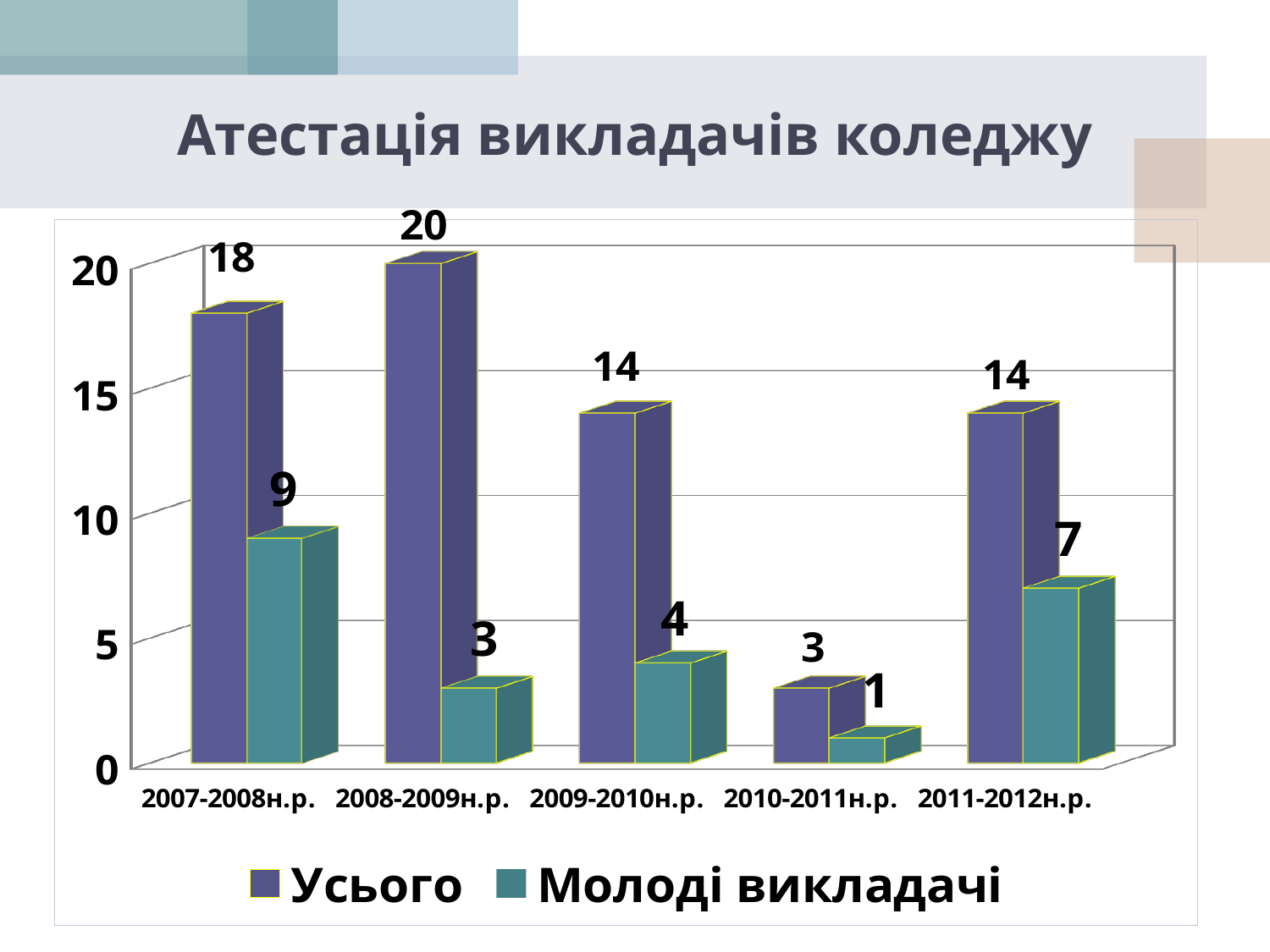
What is the difference between Усього and Молоді викладачі in 2007-2008н.р.? 9 Is the value for Усього in 2009-2010н.р. greater or less than 10? greater How many academic years are shown on the x axis? 5 What kind of chart is shown on the slide? bar chart What is the value for Усього in 2008-2009н.р.? 20 Which year has the lowest value for Молоді викладачі? 2010-2011н.р. What is the value for Молоді викладачі in 2011-2012н.р.? 7 Which year has the highest value for Усього? 2008-2009н.р. Which is larger: Молоді викладачі in 2007-2008н.р. or in 2011-2012н.р.? 2007-2008н.р. What is the value for Молоді викладачі in 2010-2011н.р.? 1 How many series does the legend list? 2 What is the title of the slide? Атестація викладачів коледжу